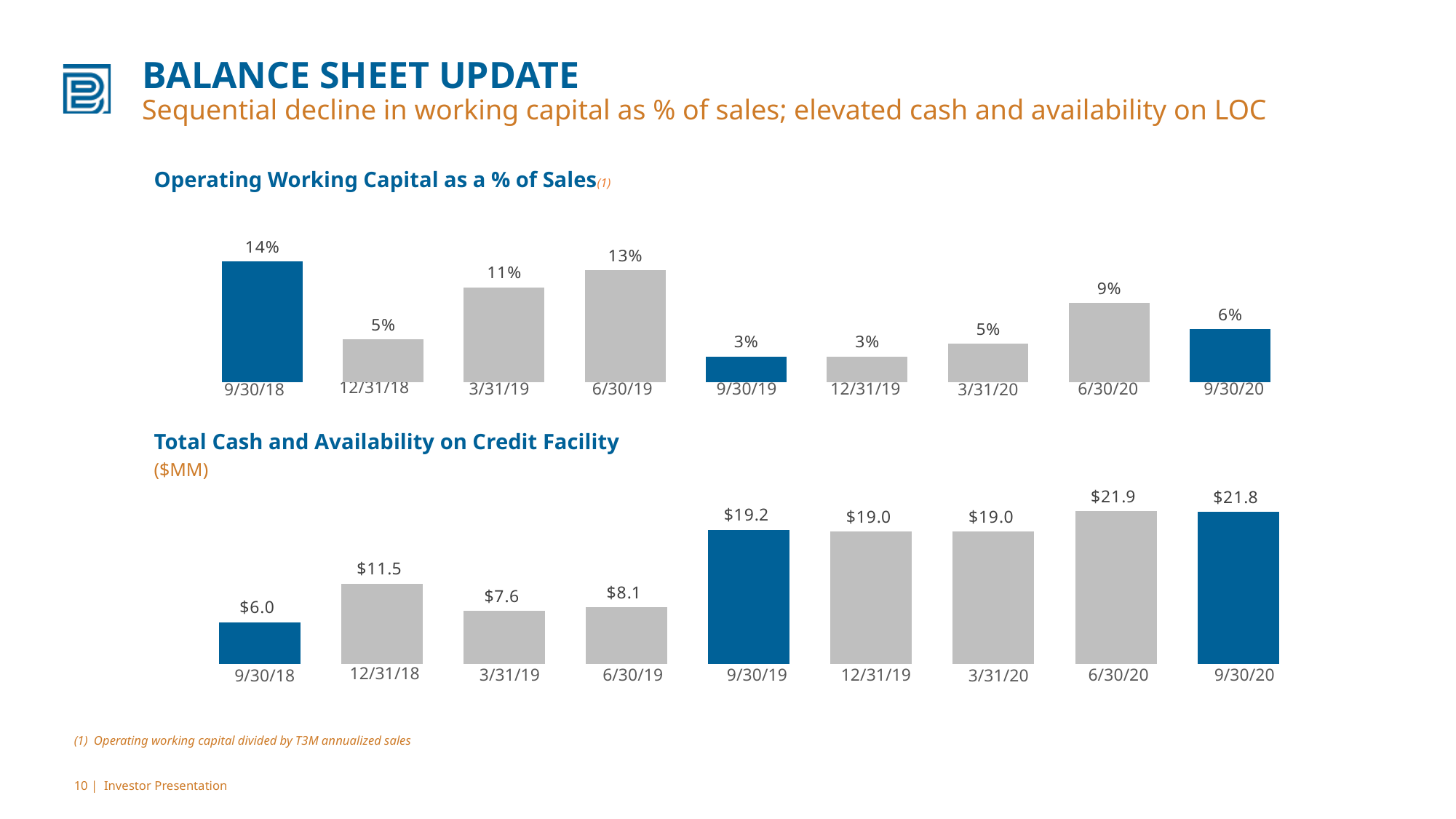
In the 'Total Cash and Availability on Credit Facility' chart, what is the difference between the values for 9/30/19 and 6/30/19? $11.1 In the 'Total Cash and Availability on Credit Facility' chart, which period has the lowest value? 9/30/18 In the 'Total Cash and Availability on Credit Facility' chart, which period has the highest value? 6/30/20 In the 'Operating Working Capital as a % of Sales' chart, which period has the highest value? 9/30/18 In the 'Total Cash and Availability on Credit Facility' chart, what is the value for 12/31/18? $11.5 In the 'Operating Working Capital as a % of Sales' chart, what is the value for 9/30/18? 14% In the 'Total Cash and Availability on Credit Facility' chart, which is larger, the value for 3/31/19 or the value for 6/30/19? 6/30/19 In the 'Operating Working Capital as a % of Sales' chart, what is the difference between the values for 6/30/19 and 9/30/19? 10 percentage points In the 'Operating Working Capital as a % of Sales' chart, what is the value for 6/30/20? 9% In what unit are the values in the 'Total Cash and Availability on Credit Facility' chart expressed? $MM What kind of chart is the 'Total Cash and Availability on Credit Facility' chart? Bar chart In the 'Operating Working Capital as a % of Sales' chart, how many periods are shown? 9